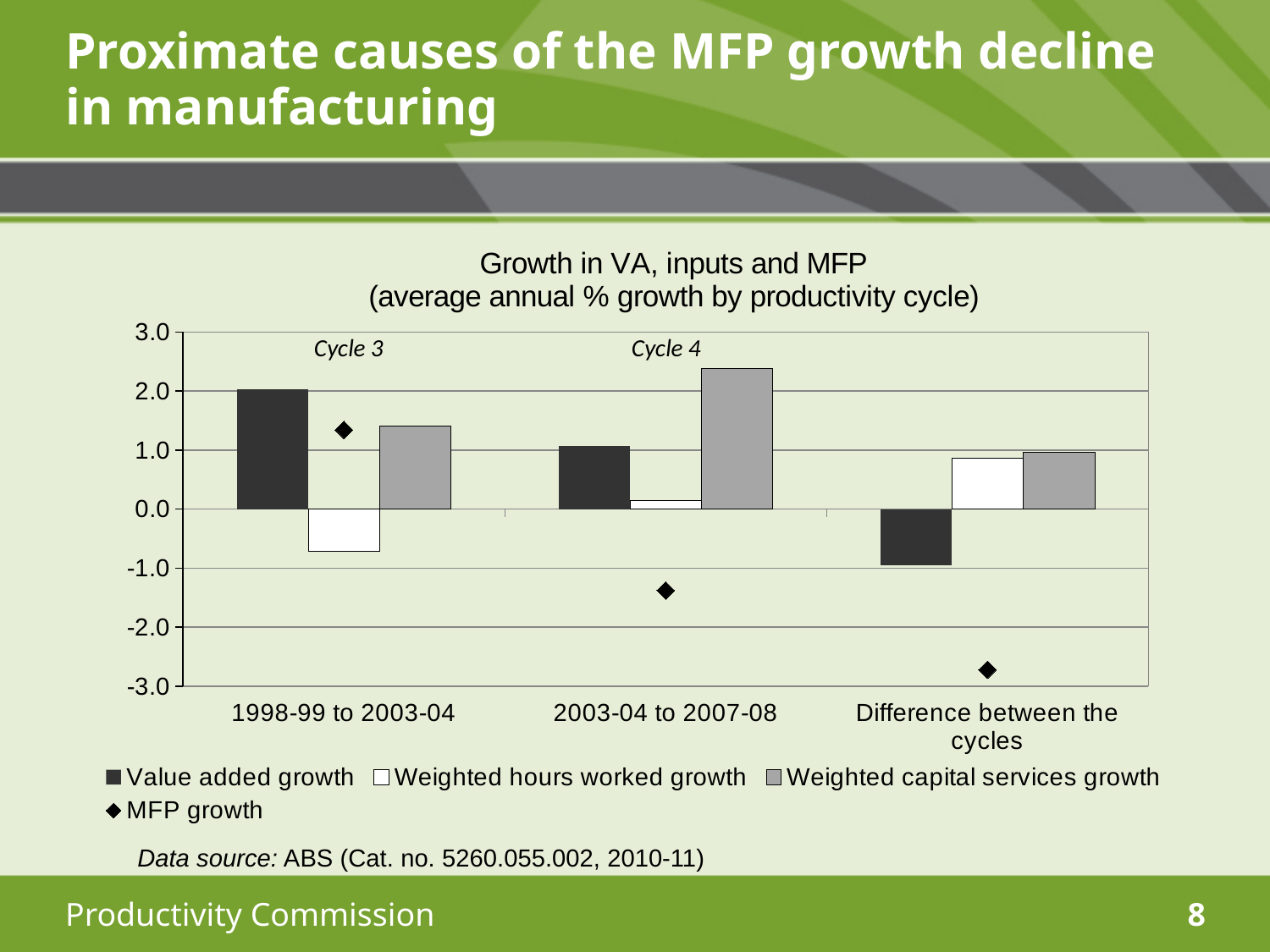
How many series does the chart's legend list? 4 Is the value for Weighted capital services growth in 2003-04 to 2007-08 greater or less than 2.0? greater Is the value for Weighted hours worked growth in 1998-99 to 2003-04 greater or less than 0.0? less What kind of chart is used to show Value added growth, Weighted hours worked growth and Weighted capital services growth? Bar chart Does MFP growth rise or fall across the categories from left to right? Fall How many categories are shown along the x axis of the chart? 3 Is the value for Value added growth in 1998-99 to 2003-04 greater or less than 1.0? greater What is the title of the chart? Growth in VA, inputs and MFP (average annual % growth by productivity cycle) In 2003-04 to 2007-08, which is larger: Value added growth or Weighted capital services growth? Weighted capital services growth In which category is Weighted capital services growth highest? 2003-04 to 2007-08